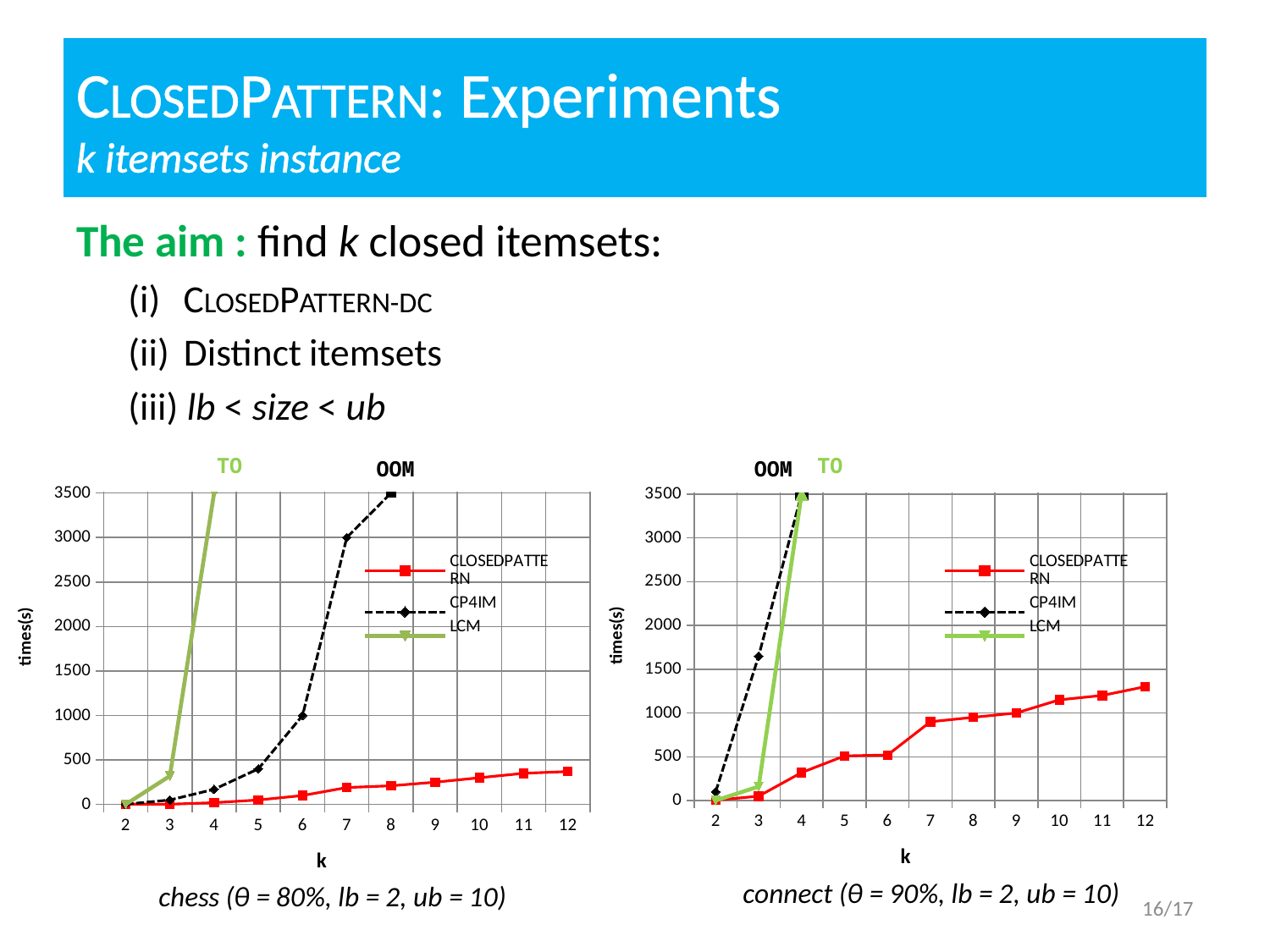
In the connect chart on the right, is the CLOSEDPATTERN value at k = 12 greater or less than 1000? greater In the connect chart on the right, at k = 3, which series has the larger value, CP4IM or LCM? CP4IM In the connect chart on the right, is the CLOSEDPATTERN value at k = 7 greater or less than 1000? less In the connect chart on the right, does the CLOSEDPATTERN series rise or fall as k increases? rise In the chess chart on the left, is the LCM value at k = 3 greater or less than 500? less In the chess chart on the left, at k = 5, which series has the larger value, CP4IM or CLOSEDPATTERN? CP4IM How many values of k are shown on the x axis of the chess chart on the left? 11 What kind of chart is the chess chart on the left? line chart How many series does the legend of the connect chart on the right list? 3 What is the label of the y axis on the chess chart on the left? times(s)